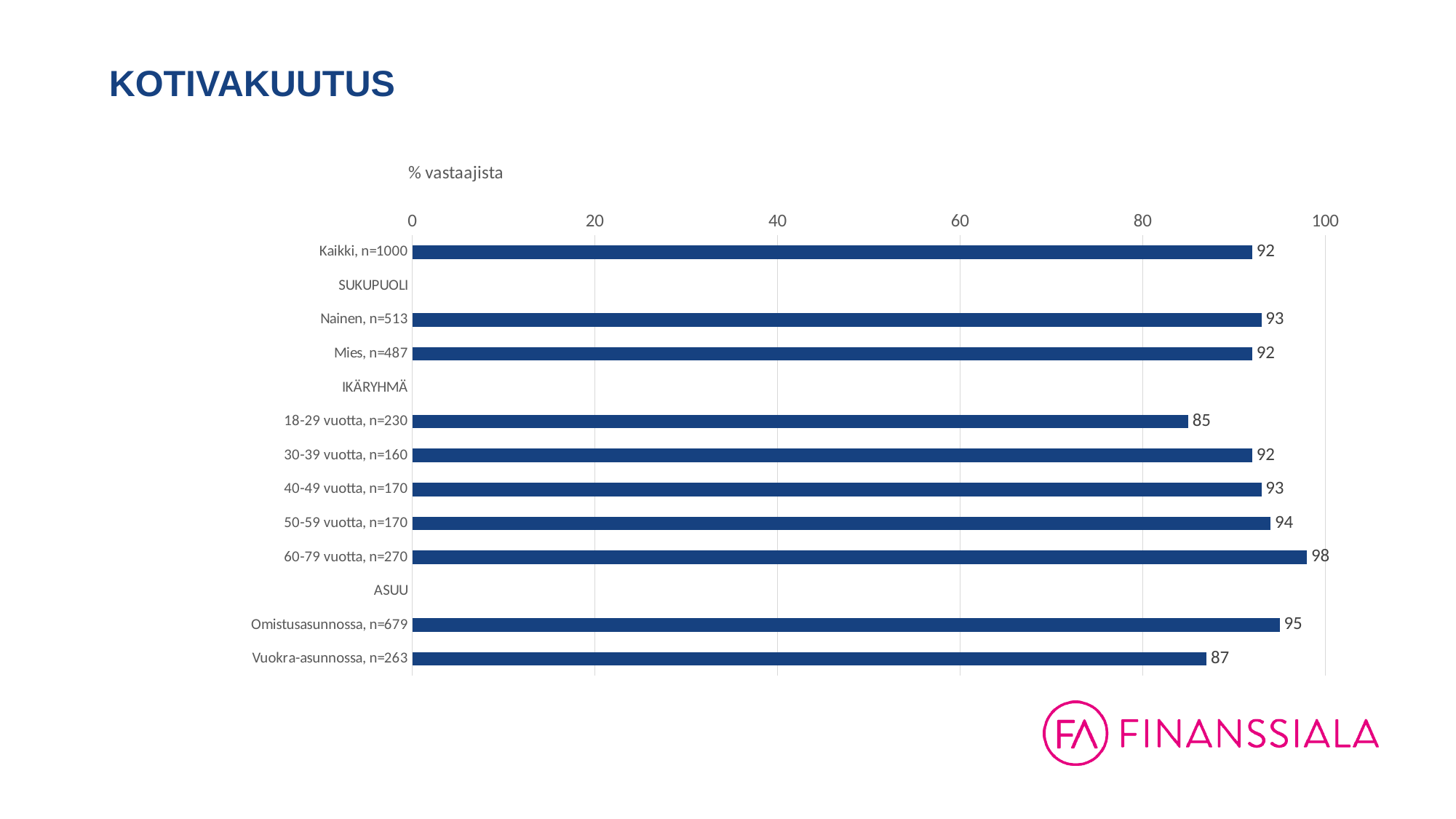
Which is larger, the value for 50-59 vuotta, n=170 or the value for 18-29 vuotta, n=230? 50-59 vuotta, n=170 What is the value for Kaikki, n=1000? 92 What is the value for 18-29 vuotta, n=230? 85 What is the title of the slide? KOTIVAKUUTUS What is the difference between the values for Omistusasunnossa, n=679 and Vuokra-asunnossa, n=263? 8 Which category has the highest value? 60-79 vuotta, n=270 What is the value for Omistusasunnossa, n=679? 95 Is the value for Vuokra-asunnossa, n=263 greater or less than 80? greater What is the value for Vuokra-asunnossa, n=263? 87 Which category has the lowest value? 18-29 vuotta, n=230 What is the difference between the values for 60-79 vuotta, n=270 and 18-29 vuotta, n=230? 13 What kind of chart is shown on the slide? bar chart